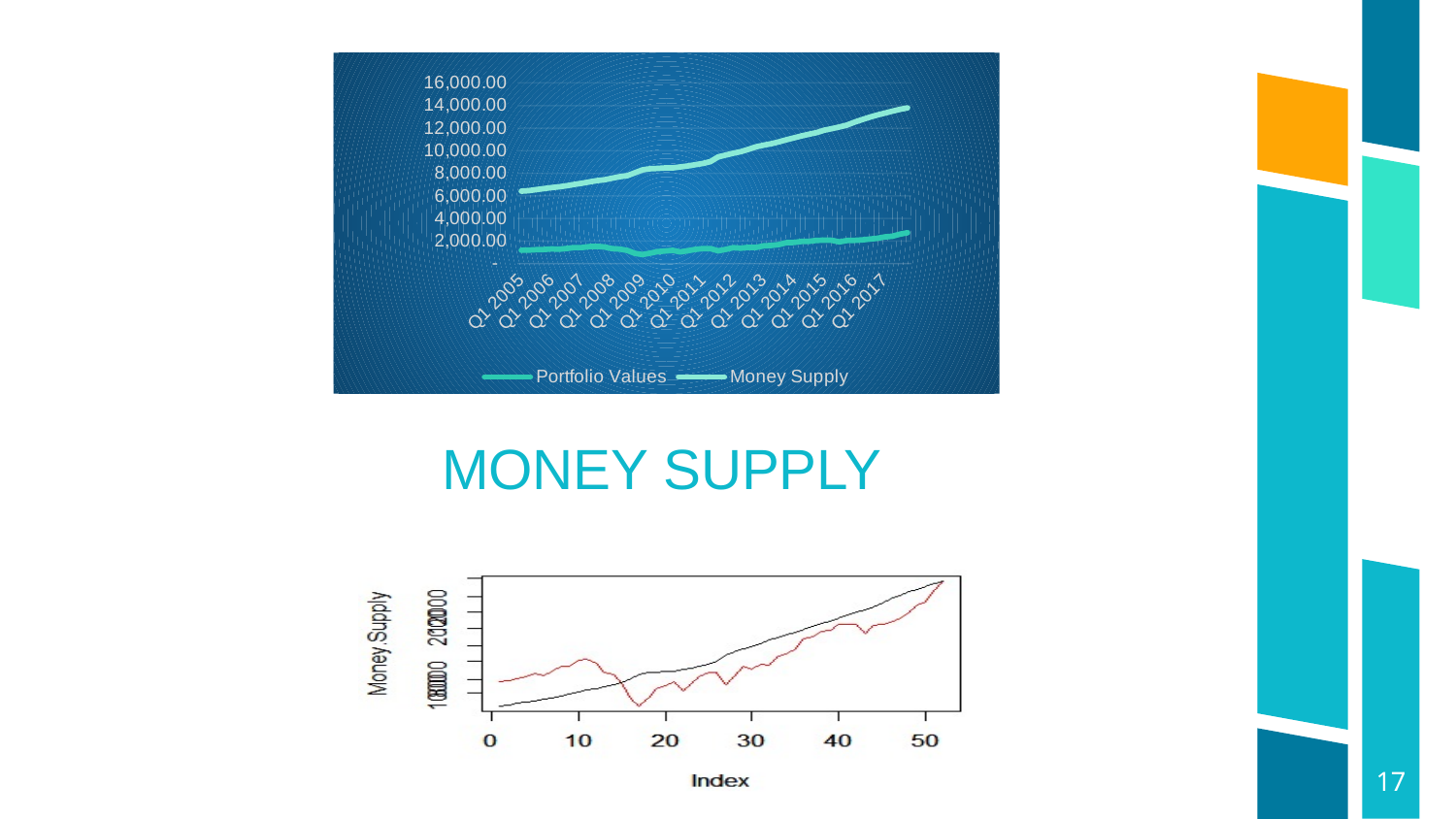
What type of chart is the top chart on the slide? line chart What is the highest value labelled on the y axis of the top chart? 16,000.00 In the bottom chart, does the black line rise or fall as Index increases? rise What are the two series named in the legend of the top chart? Portfolio Values and Money Supply In the top chart, is the Money Supply value at Q1 2017 greater or less than 12,000.00? greater How many quarter labels are shown on the x axis of the top chart? 13 In the top chart, which series has the higher values throughout, Portfolio Values or Money Supply? Money Supply How many series does the legend of the top chart list? 2 In the top chart, is the Portfolio Values value at Q1 2017 greater or less than 4,000.00? less What is the x-axis label of the bottom chart? Index In the top chart, is the Money Supply value at Q1 2005 greater or less than 8,000.00? less In the top chart, does the Money Supply series rise or fall from Q1 2005 to Q1 2017? rise